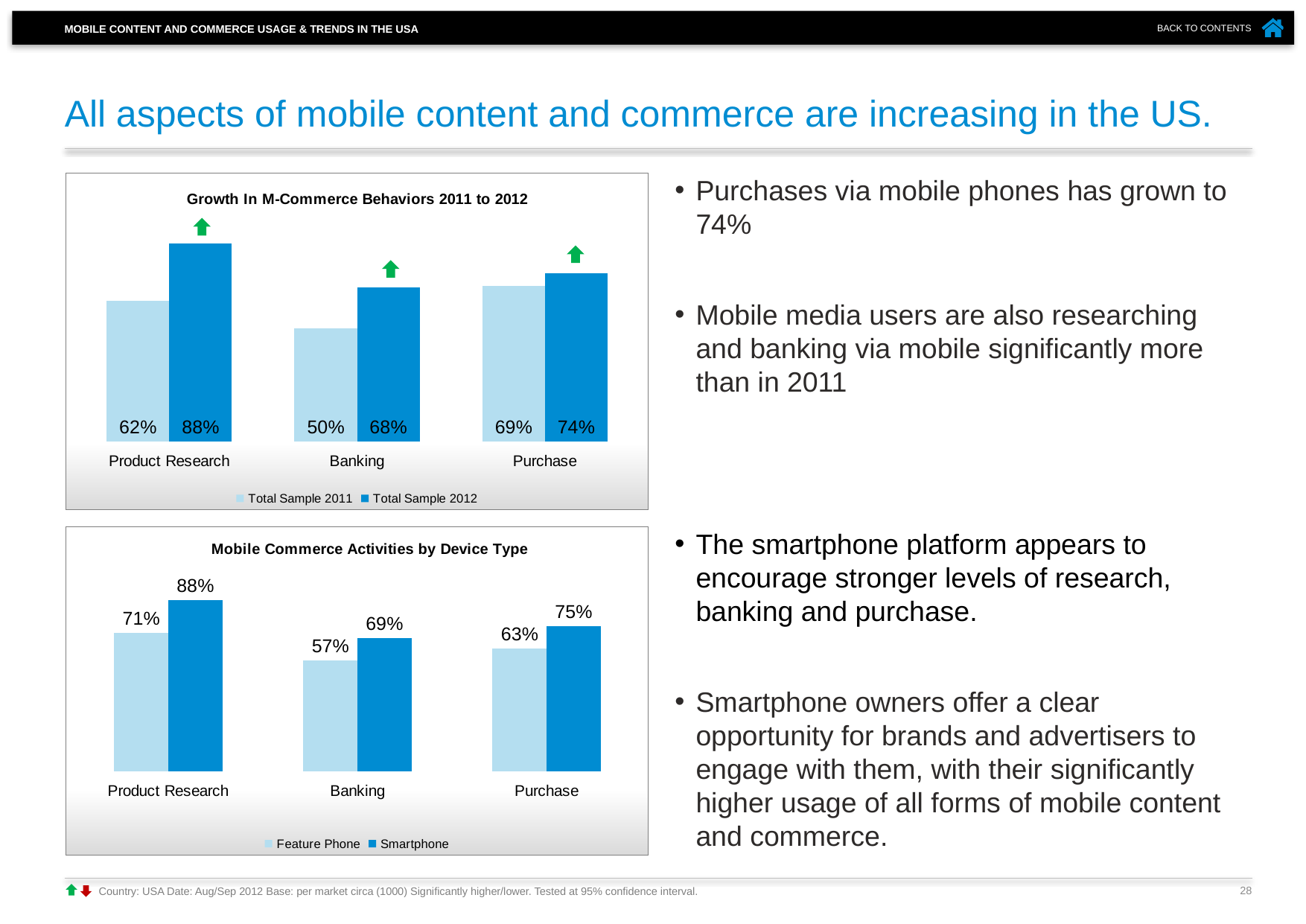
In the 'Mobile Commerce Activities by Device Type' chart, what is the Smartphone value for Purchase? 75% What type of chart is the 'Growth In M-Commerce Behaviors 2011 to 2012' chart? Bar chart How many categories are shown in the 'Mobile Commerce Activities by Device Type' chart? 3 In the 'Growth In M-Commerce Behaviors 2011 to 2012' chart, what is the difference between the 2012 and 2011 values for Product Research? 26 percentage points In the 'Growth In M-Commerce Behaviors 2011 to 2012' chart, what is the Total Sample 2011 value for Purchase? 69% In the 'Growth In M-Commerce Behaviors 2011 to 2012' chart, what is the Total Sample 2012 value for Banking? 68% In the 'Mobile Commerce Activities by Device Type' chart, what is the difference between the Smartphone and Feature Phone values for Banking? 12 percentage points In the 'Growth In M-Commerce Behaviors 2011 to 2012' chart, which category has the lowest Total Sample 2011 value? Banking In the 'Mobile Commerce Activities by Device Type' chart, what is the Feature Phone value for Banking? 57% In the 'Growth In M-Commerce Behaviors 2011 to 2012' chart, how many series does the legend list? 2 In the 'Mobile Commerce Activities by Device Type' chart, which category has the highest Smartphone value? Product Research In the 'Mobile Commerce Activities by Device Type' chart, which is larger: the Feature Phone value for Product Research or the Feature Phone value for Purchase? Product Research